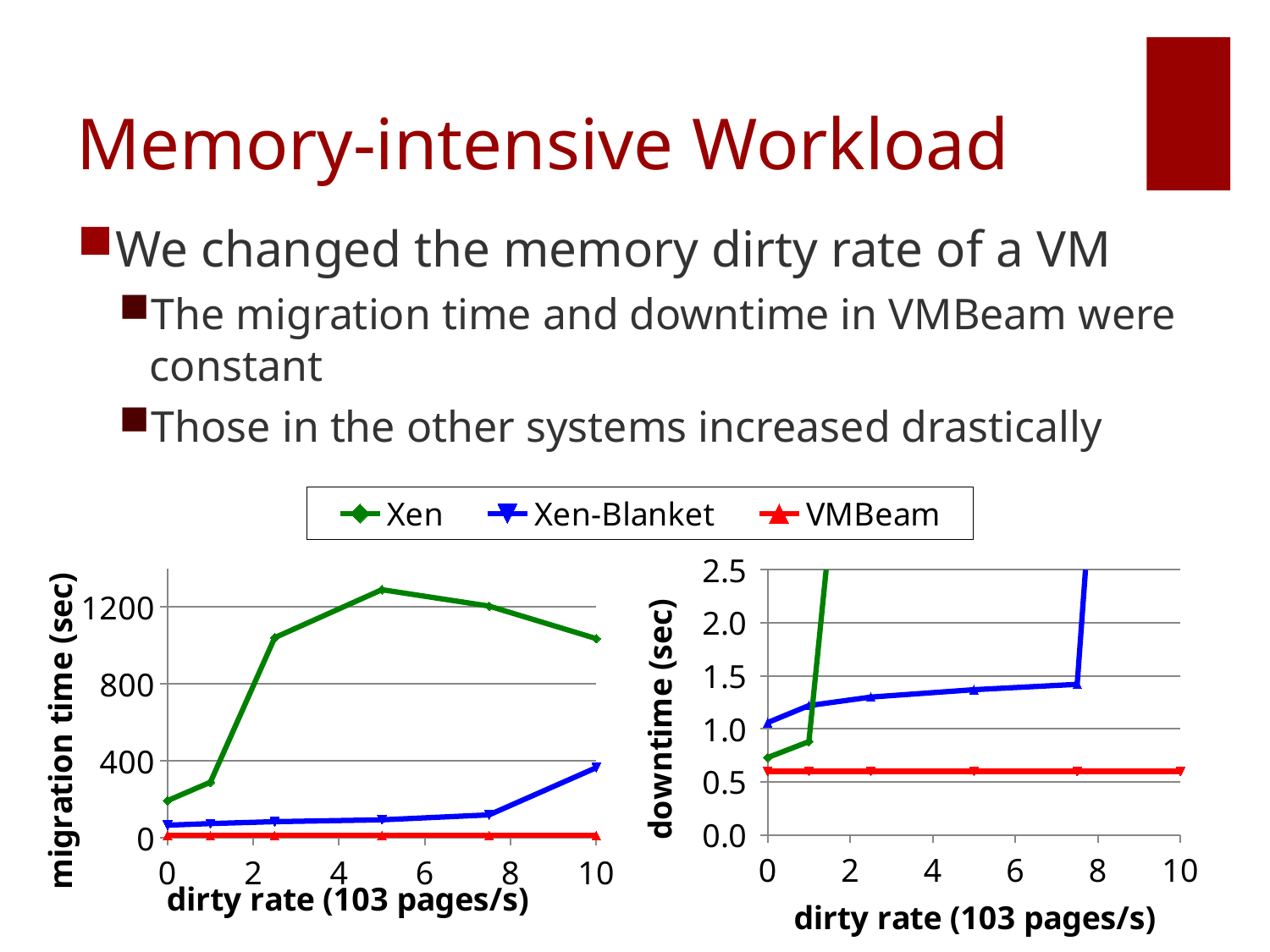
In the left chart (migration time), is the Xen value at a dirty rate of 5 greater or less than 1200? greater In the right chart (downtime), which series has the lowest downtime at a dirty rate of 5? VMBeam In the left chart (migration time), which series has the highest migration time at a dirty rate of 5? Xen In the right chart (downtime), is the Xen-Blanket value at a dirty rate of 5 greater or less than 1.0? greater In the left chart (migration time), is the Xen value at a dirty rate of 0 greater or less than 400? less How many series does the legend list? 3 In the left chart (migration time), which series has the lowest migration time across all dirty rates? VMBeam What kind of chart is the left chart showing migration time? line chart In the left chart (migration time), which is larger at a dirty rate of 10: Xen or Xen-Blanket? Xen What is the y-axis label of the right chart? downtime (sec)